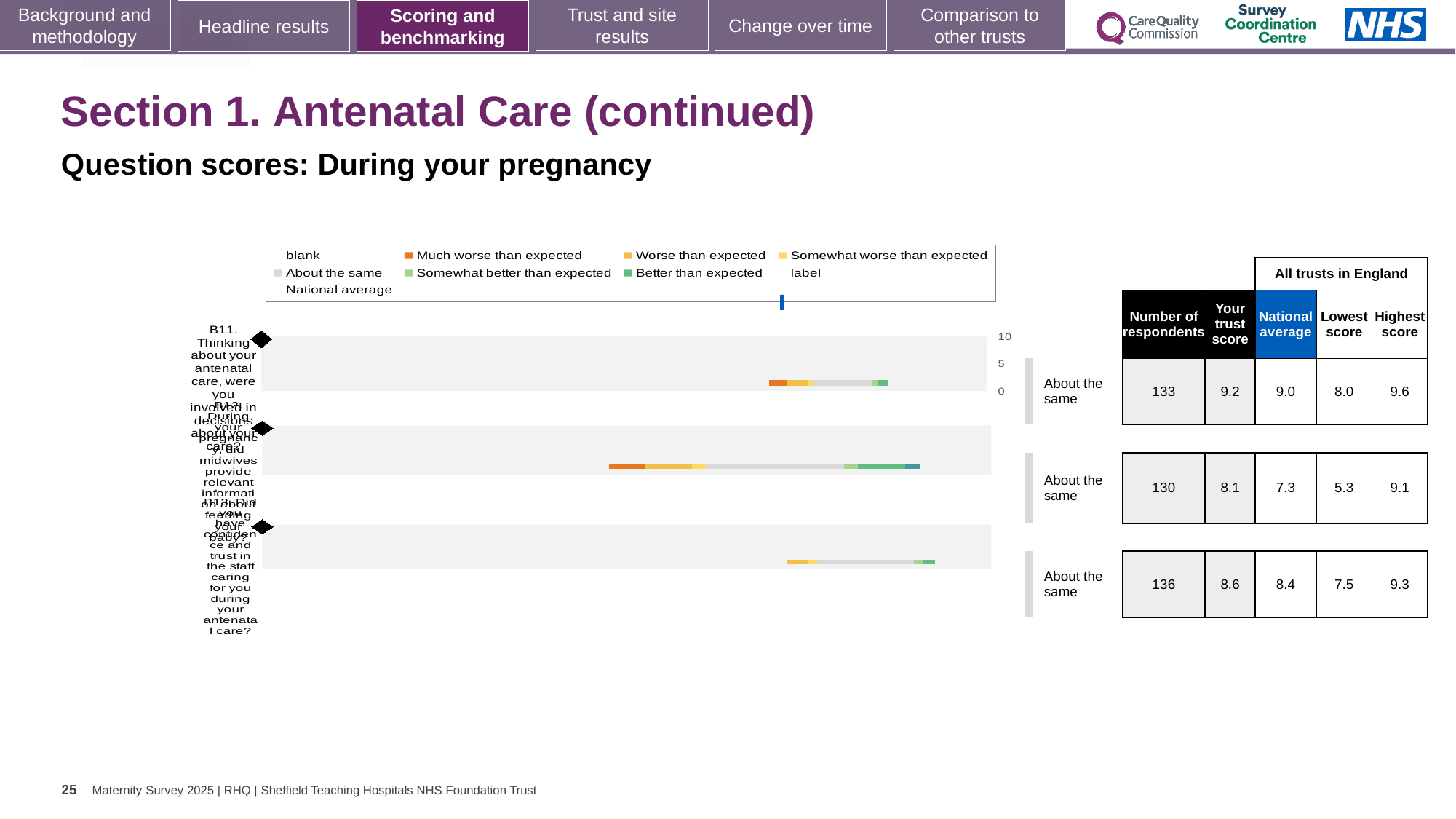
For the third row (B13), which is larger: the trust score or the national average? the trust score For the second row (B12), what is the difference between the trust score and the national average? 0.8 How many question rows (bars) are plotted in the chart? 3 What benchmark label is shown next to each of the three bars? About the same How many entries does the chart legend list? 9 Which question row has the lowest 'Lowest score' among all trusts in England? B12 What is the subtitle describing the chart's question scores? Question scores: During your pregnancy What is the national average for the third row (B13)? 8.4 What is the number of respondents for the first row (B11)? 133 What is the 'Your trust score' for the second row (B12)? 8.1 Which question row has the highest 'Your trust score'? B11 What kind of chart is shown on the slide? bar chart